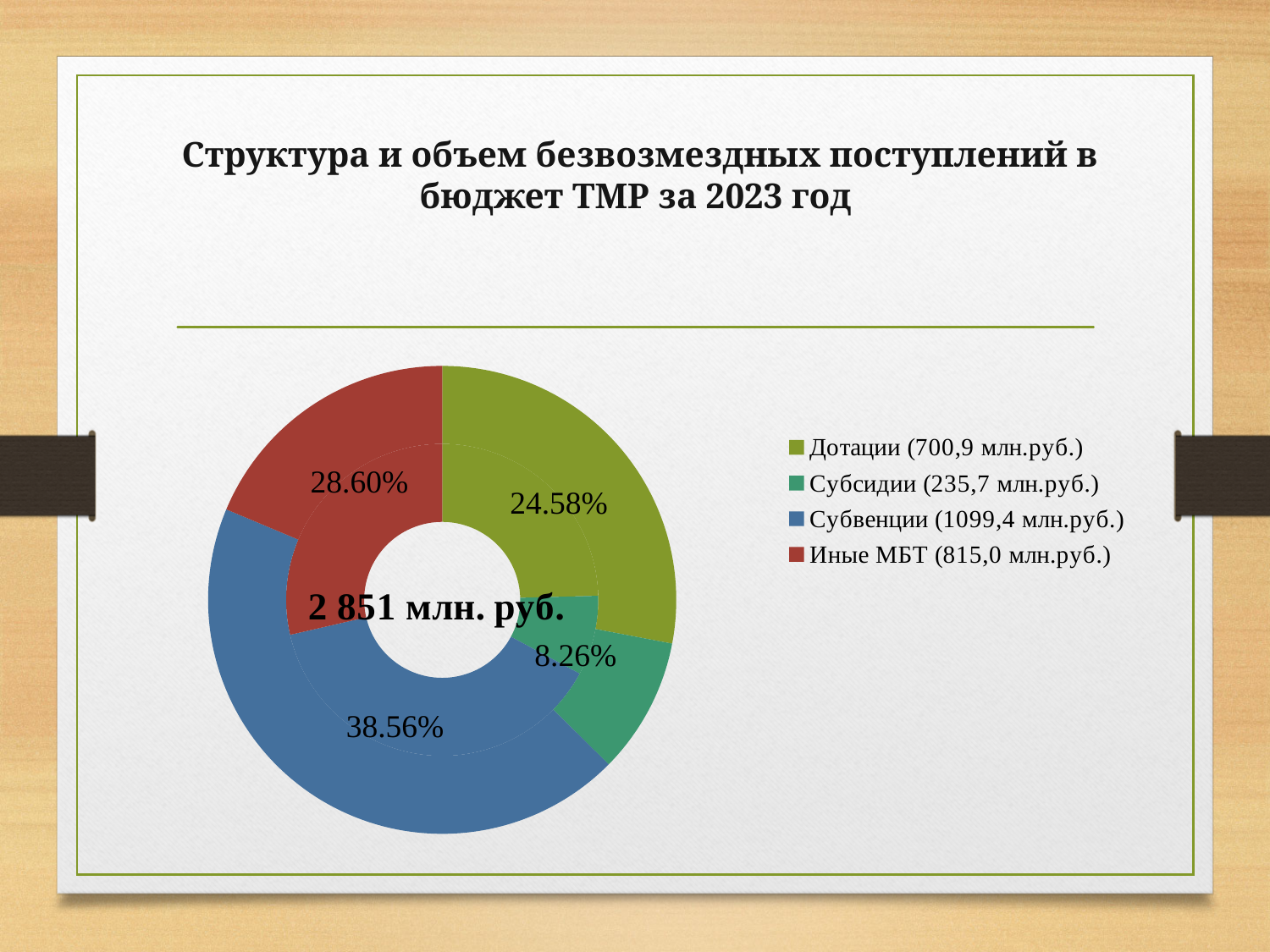
Which category has the smallest share of the chart? Субсидии What is the difference in percentage points between the shares of Субвенции and Иные МБТ? 9.96% What percentage share does Дотации have in the chart? 24.58% What percentage share does Субсидии have in the chart? 8.26% What total value is printed in the centre of the chart? 2 851 млн. руб. According to the legend, what amount corresponds to Субвенции? 1099,4 млн.руб. How many categories are shown in the chart? 4 Which has a larger share, Дотации or Иные МБТ? Иные МБТ What kind of chart is shown on the slide? doughnut chart What percentage share does Иные МБТ have in the chart? 28.60% Which category has the largest share of the chart? Субвенции What percentage share does Субвенции have in the chart? 38.56%